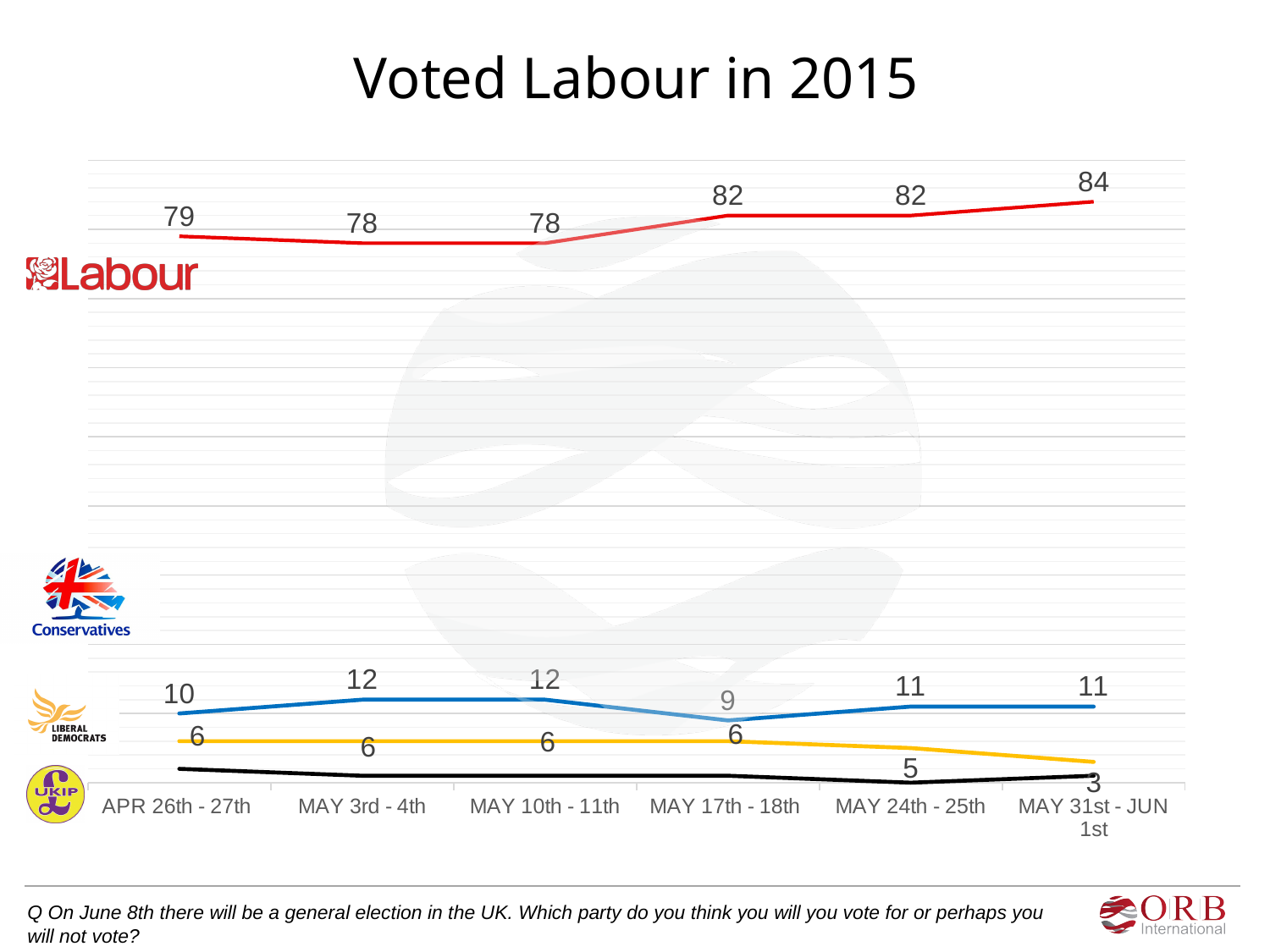
What is the value for Labour at MAY 31st - JUN 1st? 84 What kind of chart is shown on the slide? Line chart What is the title of the chart? Voted Labour in 2015 What is the difference between the Labour value at MAY 31st - JUN 1st and at APR 26th - 27th? 5 What is the value for the Conservatives at MAY 17th - 18th? 9 What is the value for Labour at APR 26th - 27th? 79 How many polling periods are shown on the x axis? 6 Which is larger: the Conservatives value at MAY 3rd - 4th or at MAY 24th - 25th? MAY 3rd - 4th Does the Labour line rise or fall between MAY 10th - 11th and MAY 31st - JUN 1st? Rise At which polling period is the Labour value highest? MAY 31st - JUN 1st What is the value for the Liberal Democrats at MAY 10th - 11th? 6 At which polling period is the Conservatives value lowest? MAY 17th - 18th